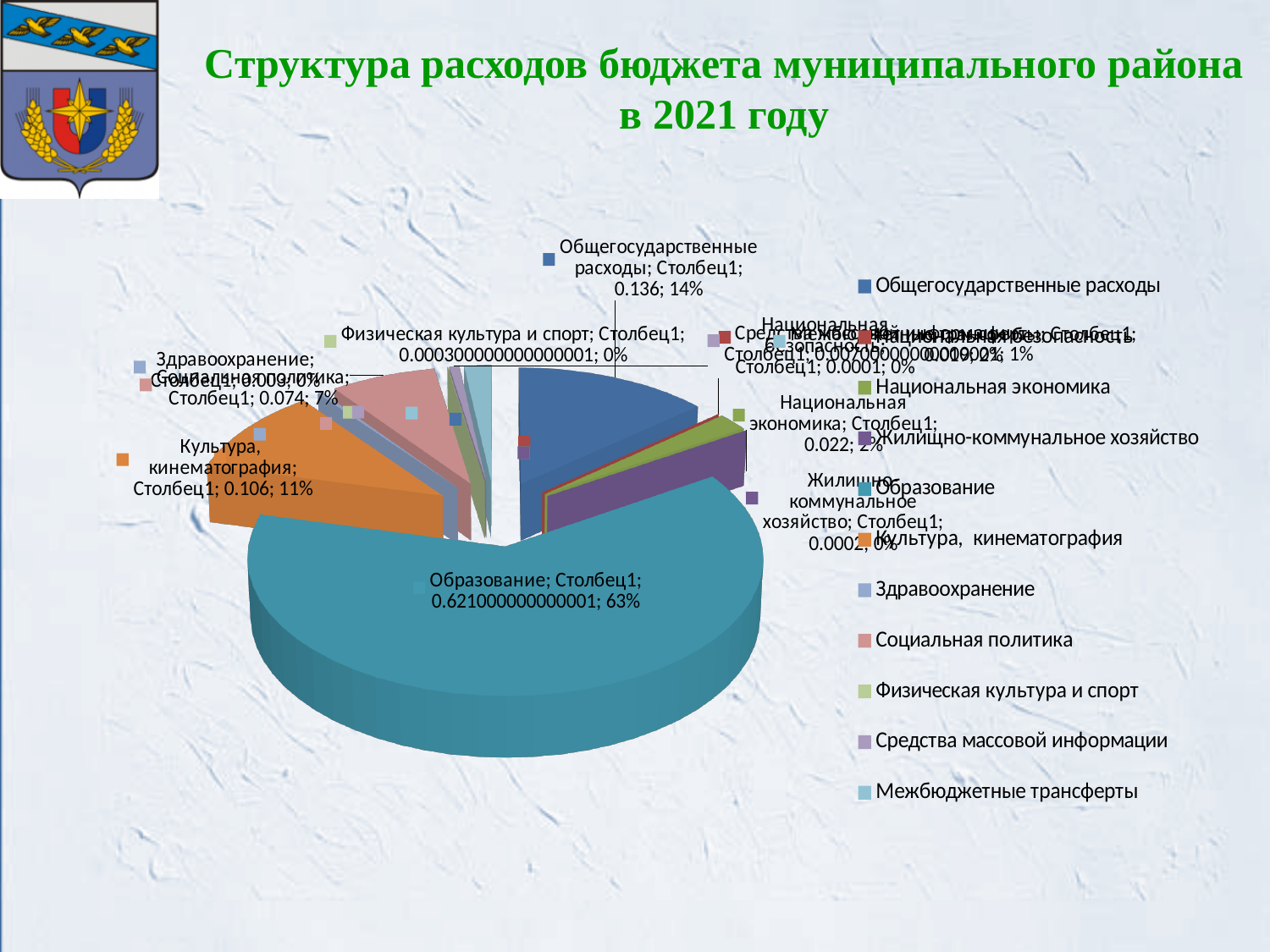
What share of the pie does Общегосударственные расходы have? 14% What kind of chart is shown on the slide? pie chart What is the difference in percentage points between the share for Образование and the share for Общегосударственные расходы? 49 What share of the pie does Национальная экономика have? 2% What value is printed for Общегосударственные расходы? 0.136 What share of the pie does Культура, кинематография have? 11% What is the title of the slide's chart? Структура расходов бюджета муниципального района в 2021 году Which is larger, the share for Культура, кинематография or the share for Социальная политика? Культура, кинематография Which category has the largest share of the pie? Образование How many categories does the legend list? 11